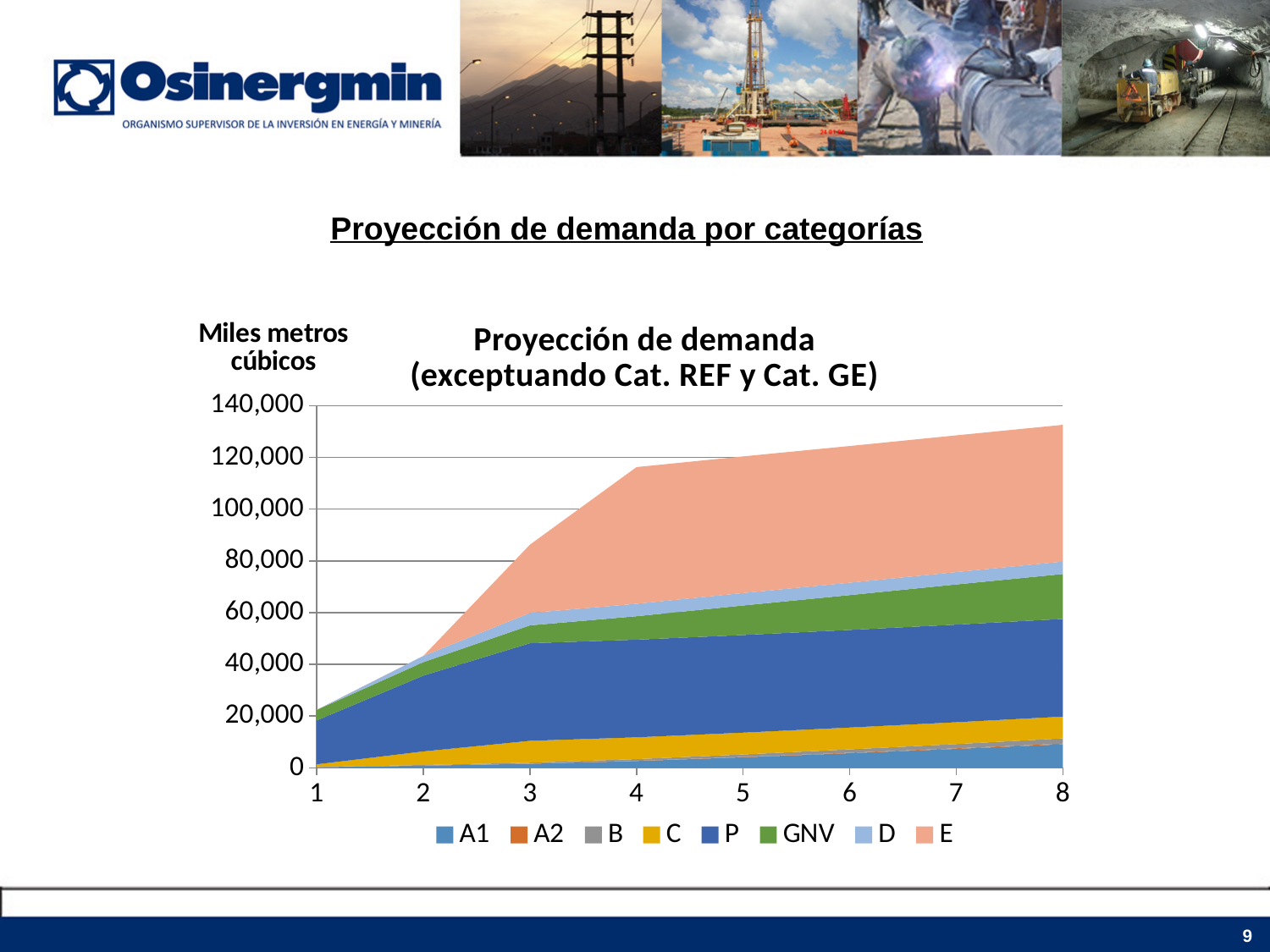
Is the total stacked value at point 8 greater or less than 120,000? greater Does the total demand rise or fall from point 1 to point 8 along the x axis? rise Is the total stacked value at point 3 greater or less than 80,000? greater At which x-axis point is the total stacked demand highest? 8 What kind of chart is shown on the slide? area chart How many series does the legend list? 8 What is the title of the chart? Proyección de demanda (exceptuando Cat. REF y Cat. GE) What unit label is shown above the y axis? Miles metros cúbicos At which x-axis point is the total stacked demand lowest? 1 Is the total stacked value at point 4 greater or less than 120,000? less How many points are plotted along the x axis? 8